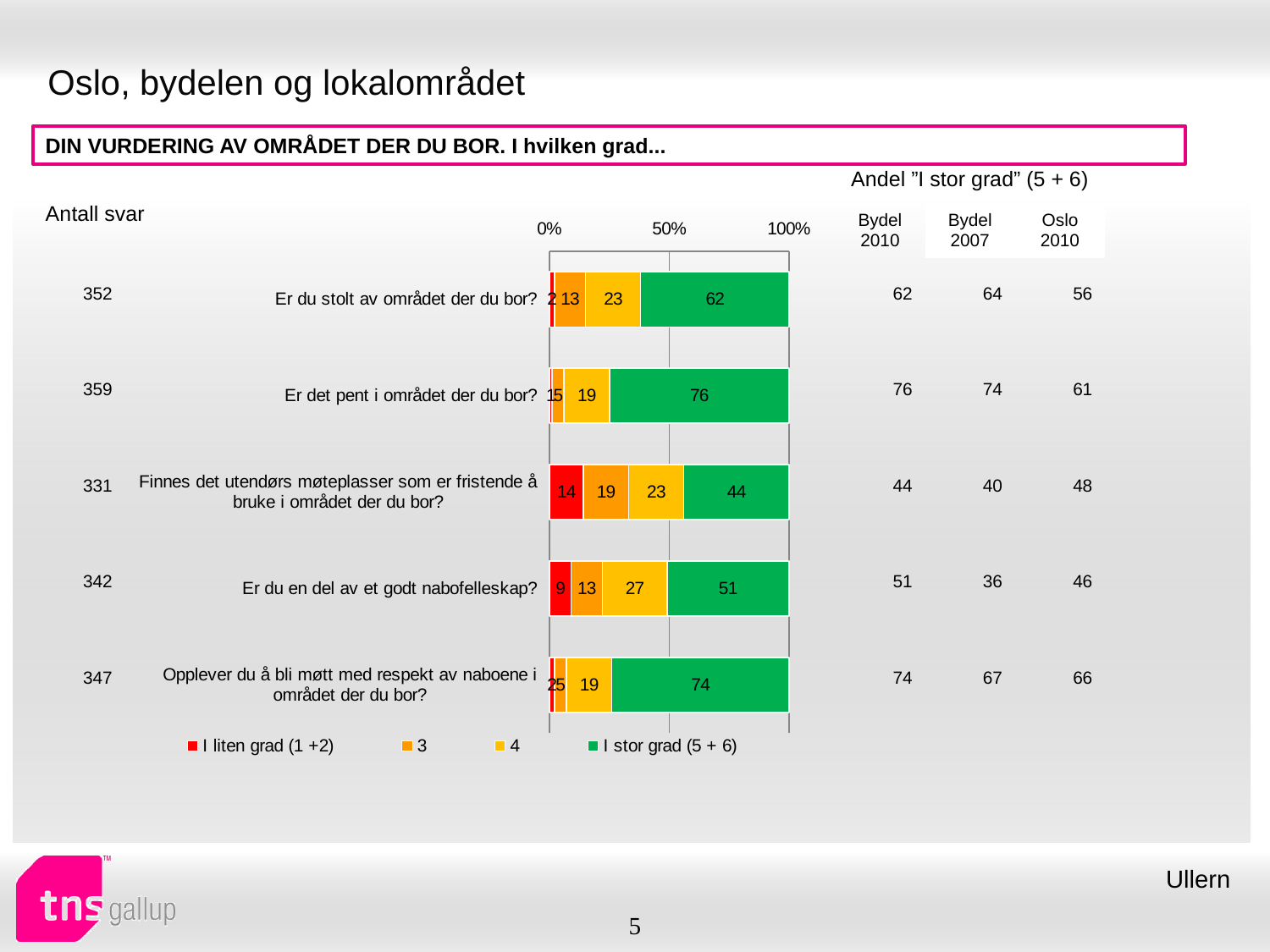
Which question has the highest 'I stor grad (5 + 6)' value? Er det pent i området der du bor? How many series does the chart legend list? 4 What is the difference between the 'I stor grad (5 + 6)' values for 'Er det pent i området der du bor?' and 'Er du stolt av området der du bor?'? 14 Which has a larger 'I stor grad (5 + 6)' value: 'Er du en del av et godt nabofelleskap?' or 'Opplever du å bli møtt med respekt av naboene i området der du bor?'? Opplever du å bli møtt med respekt av naboene i området der du bor? What is the label of the green series in the chart legend? I stor grad (5 + 6) What is the 'I stor grad (5 + 6)' value for 'Er det pent i området der du bor?'? 76 How many questions (categories) are plotted in the chart? 5 What is the value for series '4' for 'Er du en del av et godt nabofelleskap?'? 27 What kind of chart is shown on the slide? stacked bar chart Which question has the lowest 'I stor grad (5 + 6)' value? Finnes det utendørs møteplasser som er fristende å bruke i området der du bor? What is the 'I liten grad (1 +2)' value for 'Finnes det utendørs møteplasser som er fristende å bruke i området der du bor?'? 14 What is the 'I stor grad (5 + 6)' value for 'Er du stolt av området der du bor?'? 62